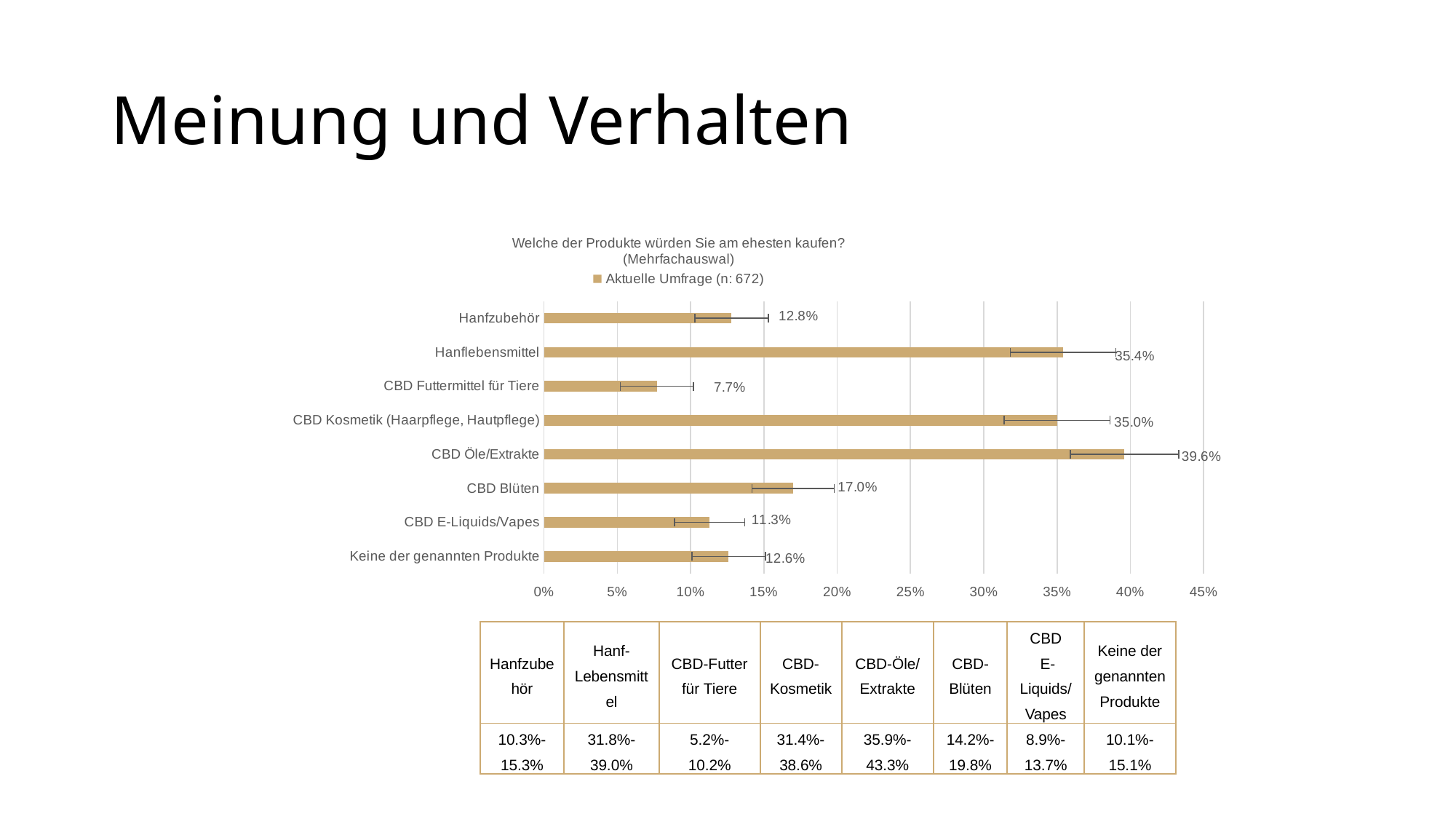
What is the value for CBD Blüten? 17.0% What is the value for Hanflebensmittel? 35.4% What is the difference between the values for CBD Öle/Extrakte and CBD Blüten? 22.6% What is the value for CBD Futtermittel für Tiere? 7.7% What is the value for CBD Öle/Extrakte? 39.6% Which category has the lowest value? CBD Futtermittel für Tiere Which is larger, the value for CBD E-Liquids/Vapes or the value for Hanfzubehör? Hanfzubehör What kind of chart is shown on the slide? bar chart What is the legend entry of the series shown in the chart? Aktuelle Umfrage (n: 672) Which category has the highest value? CBD Öle/Extrakte How many categories are shown in the chart? 8 Is the value for CBD Kosmetik (Haarpflege, Hautpflege) greater or less than 30%? greater